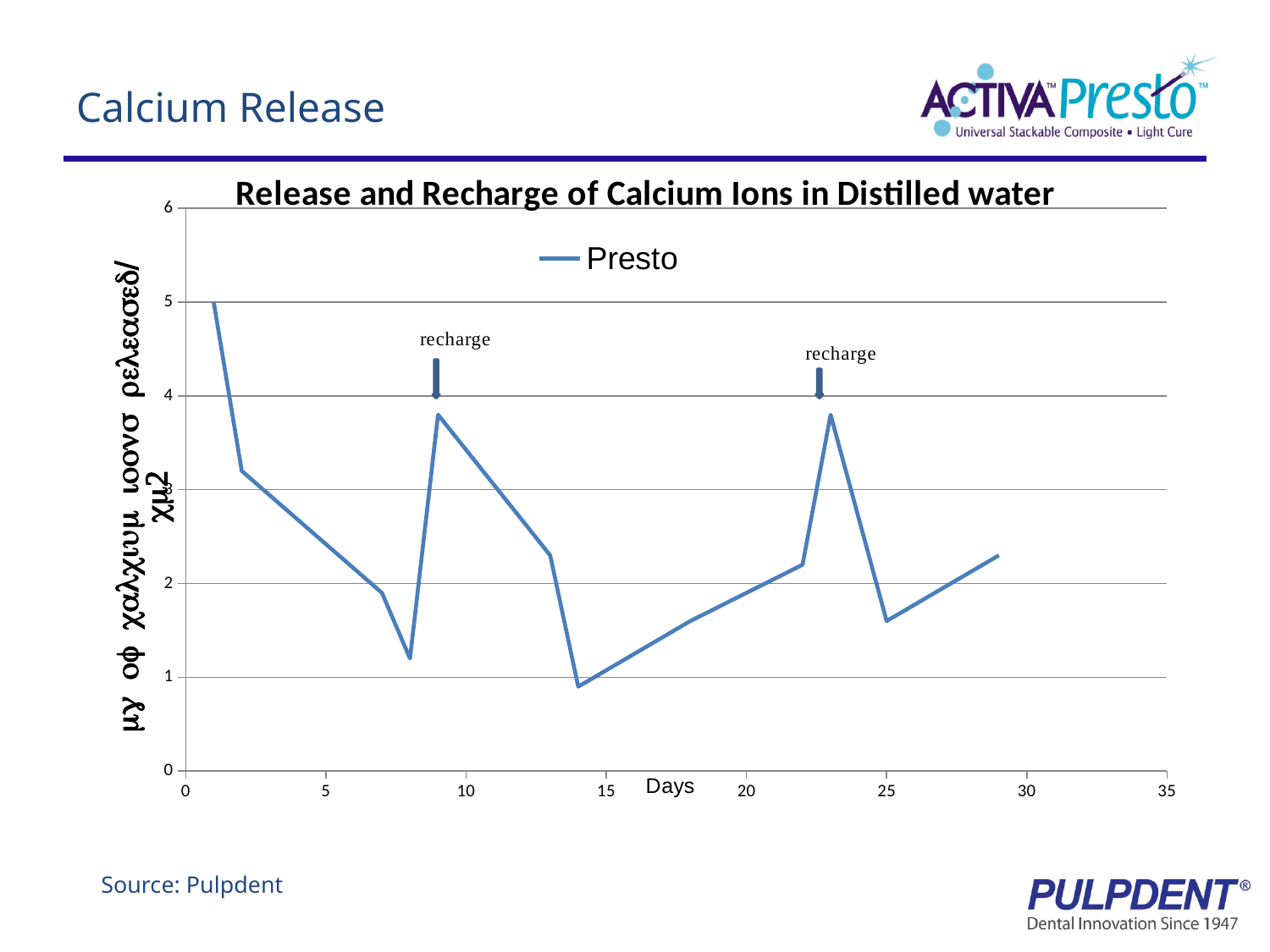
What kind of chart is shown on the slide? line chart Do the values for Presto rise or fall between day 1 and day 8? fall Is the value for Presto at day 9 greater or less than 4? less Do the values for Presto rise or fall between day 14 and day 22? rise At which day does the Presto line reach its highest value? day 1 Is the value for Presto at day 2 greater or less than 3? greater What is the title of the chart? Release and Recharge of Calcium Ions in Distilled water Which is larger, the Presto value at day 2 or at day 13? day 2 How many series does the chart legend list? 1 What is the name of the series shown in the chart legend? Presto Is the value for Presto at day 25 greater or less than 2? less